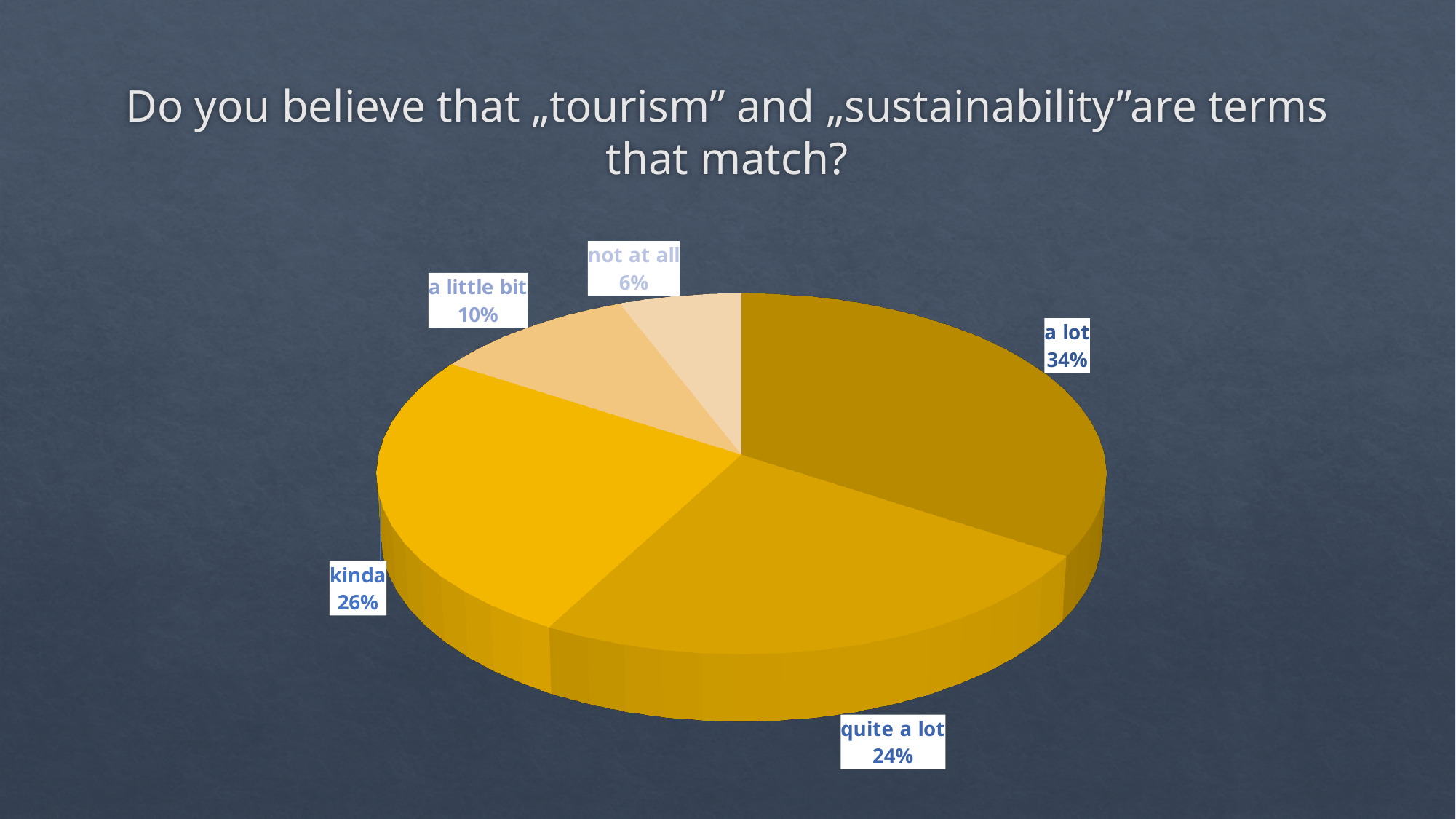
What share of respondents answered "not at all"? 6% Which answer has the smallest share of the pie? not at all What is the difference in percentage points between "a lot" and "quite a lot"? 10 What share of respondents answered "kinda"? 26% How many slices does the pie chart have? 5 Which answer has the largest share of the pie? a lot What share of respondents answered "quite a lot"? 24% What is the title of the chart? Do you believe that „tourism” and „sustainability”are terms that match? What kind of chart is shown on the slide? pie chart What share of respondents answered "a little bit"? 10% Which is larger, the share for "kinda" or the share for "a little bit"? kinda What share of respondents answered "a lot"? 34%